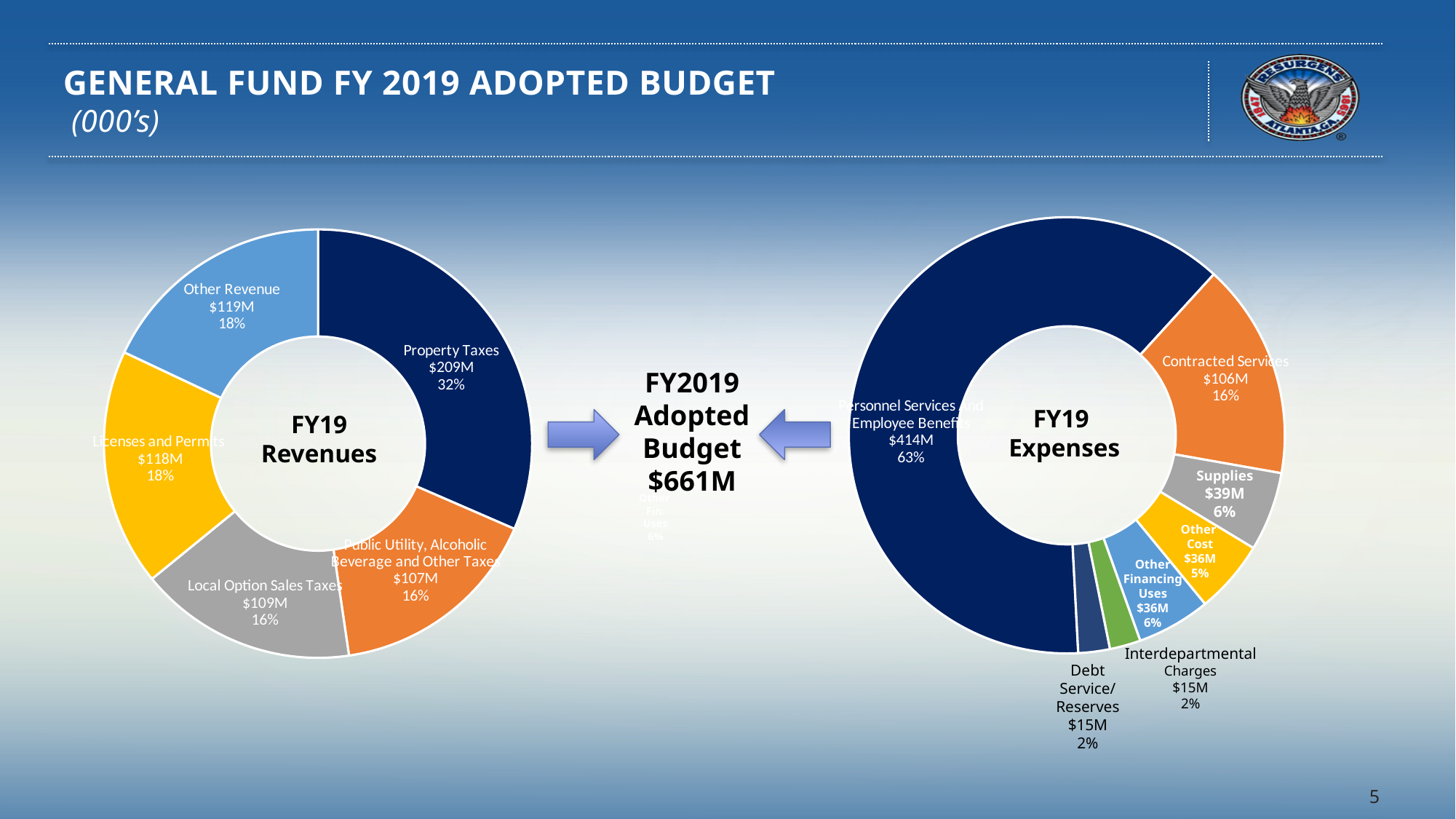
In the FY19 Expenses chart, how many categories are shown? 7 What total FY2019 Adopted Budget is shown between the two charts? $661M In the FY19 Expenses chart, what is the difference between Contracted Services and Supplies? $67M In the FY19 Revenues chart, what is the difference between Other Revenue and Local Option Sales Taxes? $10M In the FY19 Expenses chart, which is larger, Supplies or Other Cost? Supplies In the FY19 Expenses chart, what is the value for Personnel Services and Employee Benefits? $414M In the FY19 Revenues chart, what is the value for Property Taxes? $209M In the FY19 Revenues chart, how many categories are shown? 5 In the FY19 Revenues chart, what share of revenues comes from Licenses and Permits? 18% In the FY19 Expenses chart, what share of expenses is Contracted Services? 16% What kind of chart is the FY19 Expenses chart? Donut (pie) chart In the FY19 Revenues chart, which category is the largest? Property Taxes